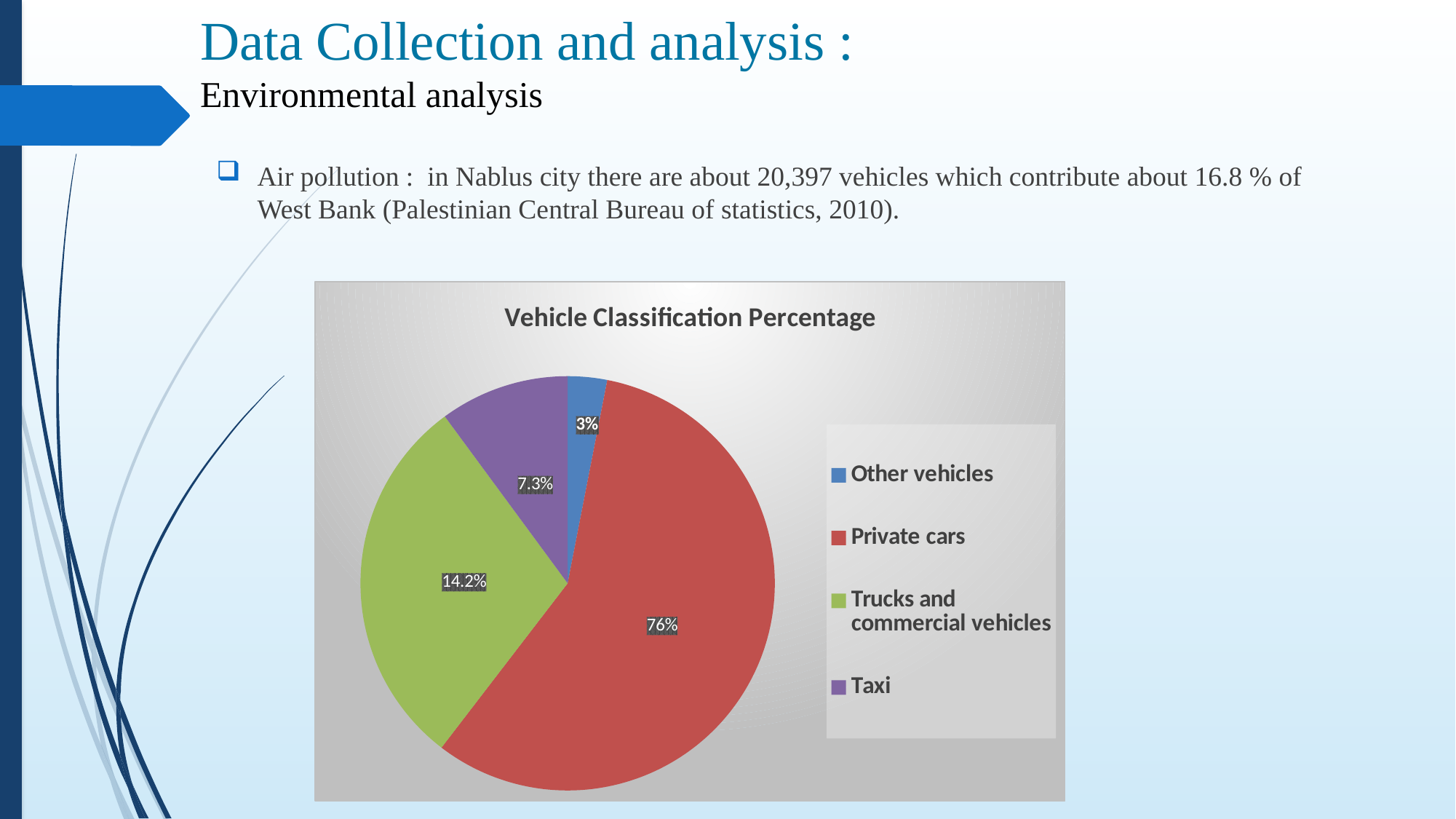
What is the title of the chart? Vehicle Classification Percentage Which category has the smallest share of the pie? Other vehicles What percentage of the pie is Other vehicles? 3% Which is larger, the share for Taxi or the share for Trucks and commercial vehicles? Trucks and commercial vehicles What percentage of the pie is Trucks and commercial vehicles? 14.2% How many categories does the pie chart show? 4 Which category has the largest share of the pie? Private cars What type of chart is shown on the slide? Pie chart What percentage of the pie is Taxi? 7.3% What colour represents Taxi in the pie chart? Purple What is the difference between the Private cars share and the Trucks and commercial vehicles share? 61.8% What percentage of the pie is Private cars? 76%